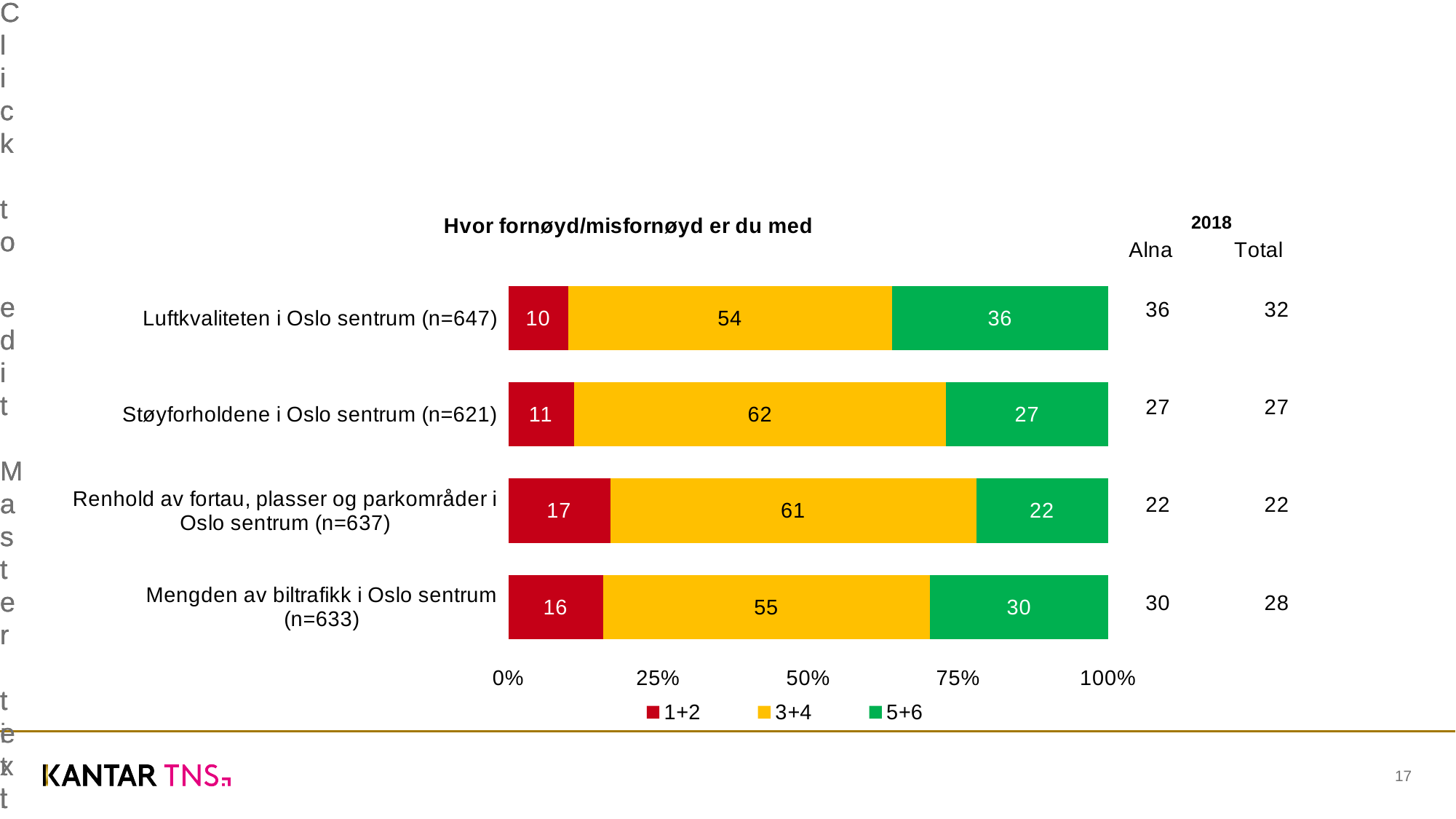
How many series does the legend list? 3 What is the title of the chart? Hvor fornøyd/misfornøyd er du med Which category has the lowest value for the 1+2 series? Luftkvaliteten i Oslo sentrum (n=647) What is the value of the 5+6 series for Mengden av biltrafikk i Oslo sentrum (n=633)? 30 What is the total of the stacked bar for Mengden av biltrafikk i Oslo sentrum (n=633)? 101 What kind of chart is shown on the slide? Stacked bar chart How many categories are shown in the chart? 4 What is the value of the 1+2 series for Renhold av fortau, plasser og parkområder i Oslo sentrum (n=637)? 17 Which is larger: the 5+6 value for Støyforholdene i Oslo sentrum (n=621) or for Renhold av fortau, plasser og parkområder i Oslo sentrum (n=637)? Støyforholdene i Oslo sentrum (n=621) What is the value of the 3+4 series for Støyforholdene i Oslo sentrum (n=621)? 62 Which category has the highest value for the 5+6 series? Luftkvaliteten i Oslo sentrum (n=647) What is the difference between the 3+4 values for Støyforholdene i Oslo sentrum (n=621) and Luftkvaliteten i Oslo sentrum (n=647)? 8